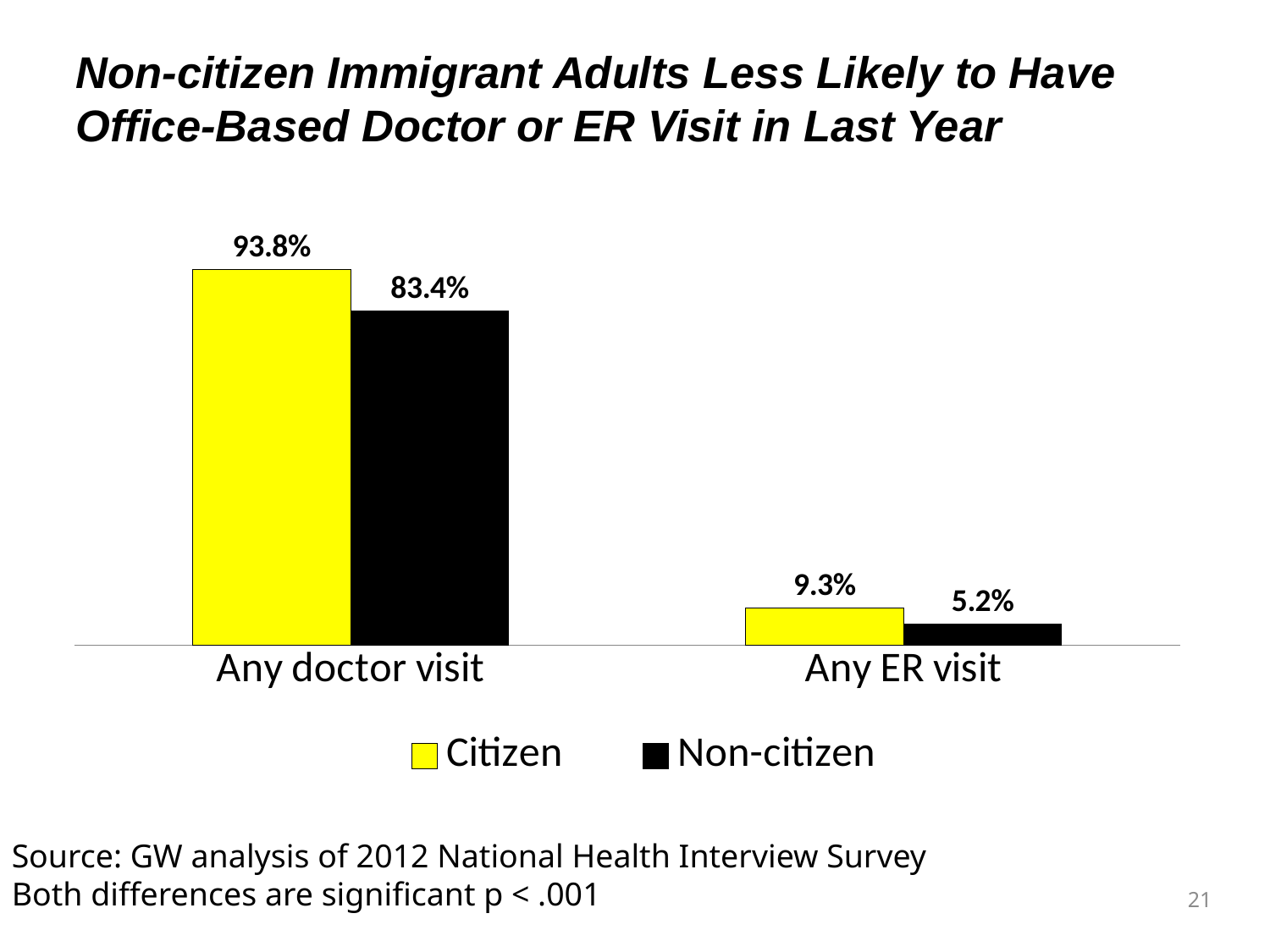
What is the value for Citizen in the Any ER visit category? 9.3% Which category has the lowest value for the Non-citizen series? Any ER visit How many series does the legend list? 2 What is the value for Non-citizen in the Any doctor visit category? 83.4% What is the difference between the Citizen and Non-citizen values for Any doctor visit? 10.4 percentage points What is the value for Citizen in the Any doctor visit category? 93.8% Which is larger for Any ER visit, the Citizen value or the Non-citizen value? Citizen What is the difference between the Citizen and Non-citizen values for Any ER visit? 4.1 percentage points Which category has the highest value for the Citizen series? Any doctor visit How many categories are shown on the x axis? 2 What kind of chart is shown on the slide? Bar chart What is the value for Non-citizen in the Any ER visit category? 5.2%